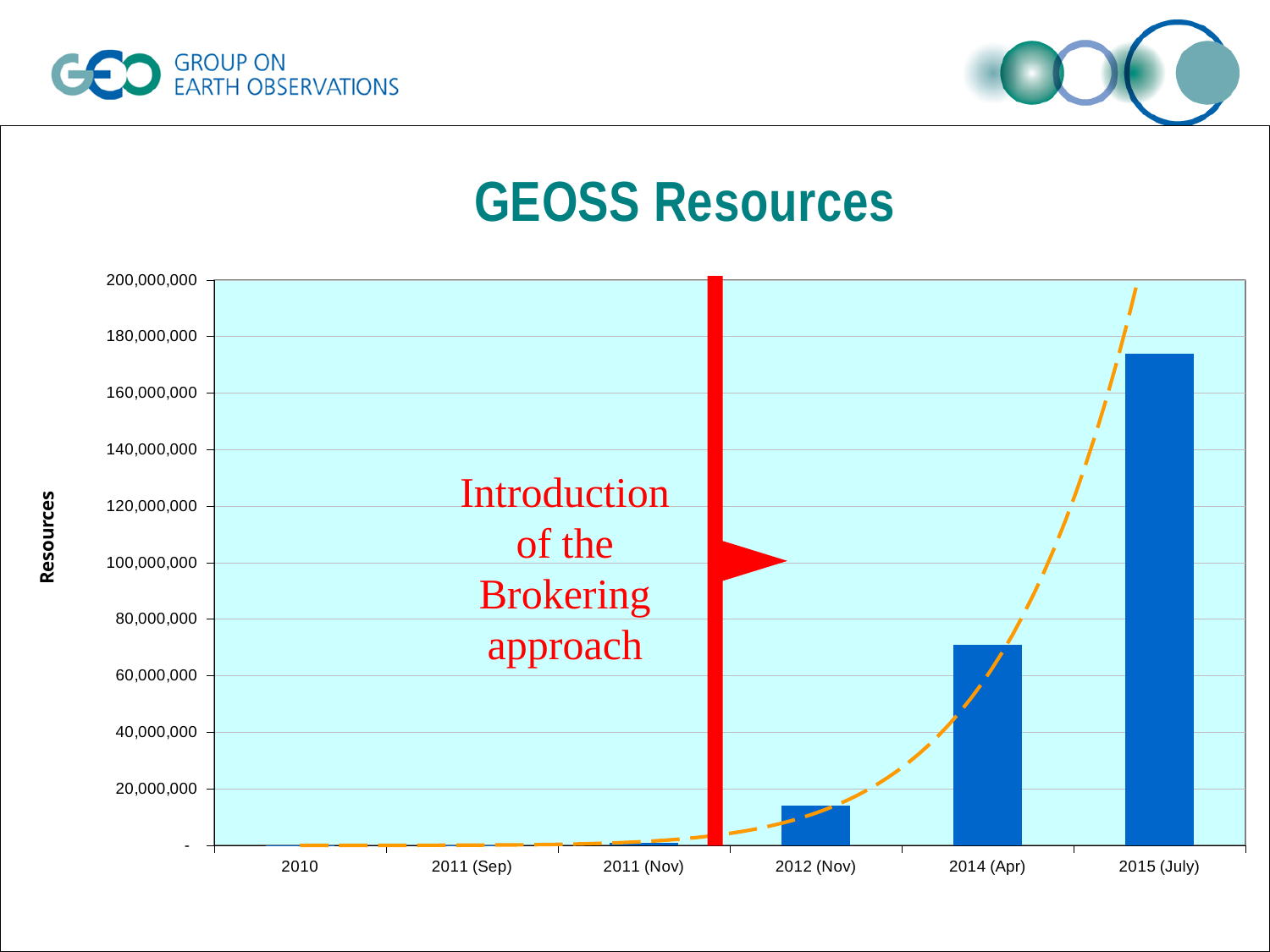
What is the title of the chart? GEOSS Resources What type of chart is shown on the slide? bar chart Is the value for 2015 (July) greater or less than 160,000,000? greater Which category has the highest value in the chart? 2015 (July) Is the value for 2012 (Nov) greater or less than 20,000,000? less How many categories are shown on the x axis of the chart? 6 Is the value for 2014 (Apr) greater or less than 60,000,000? greater Do the values rise or fall along the x axis from 2010 to 2015 (July)? rise Which is larger, the value for 2014 (Apr) or the value for 2012 (Nov)? 2014 (Apr) What label is shown on the vertical axis of the chart? Resources